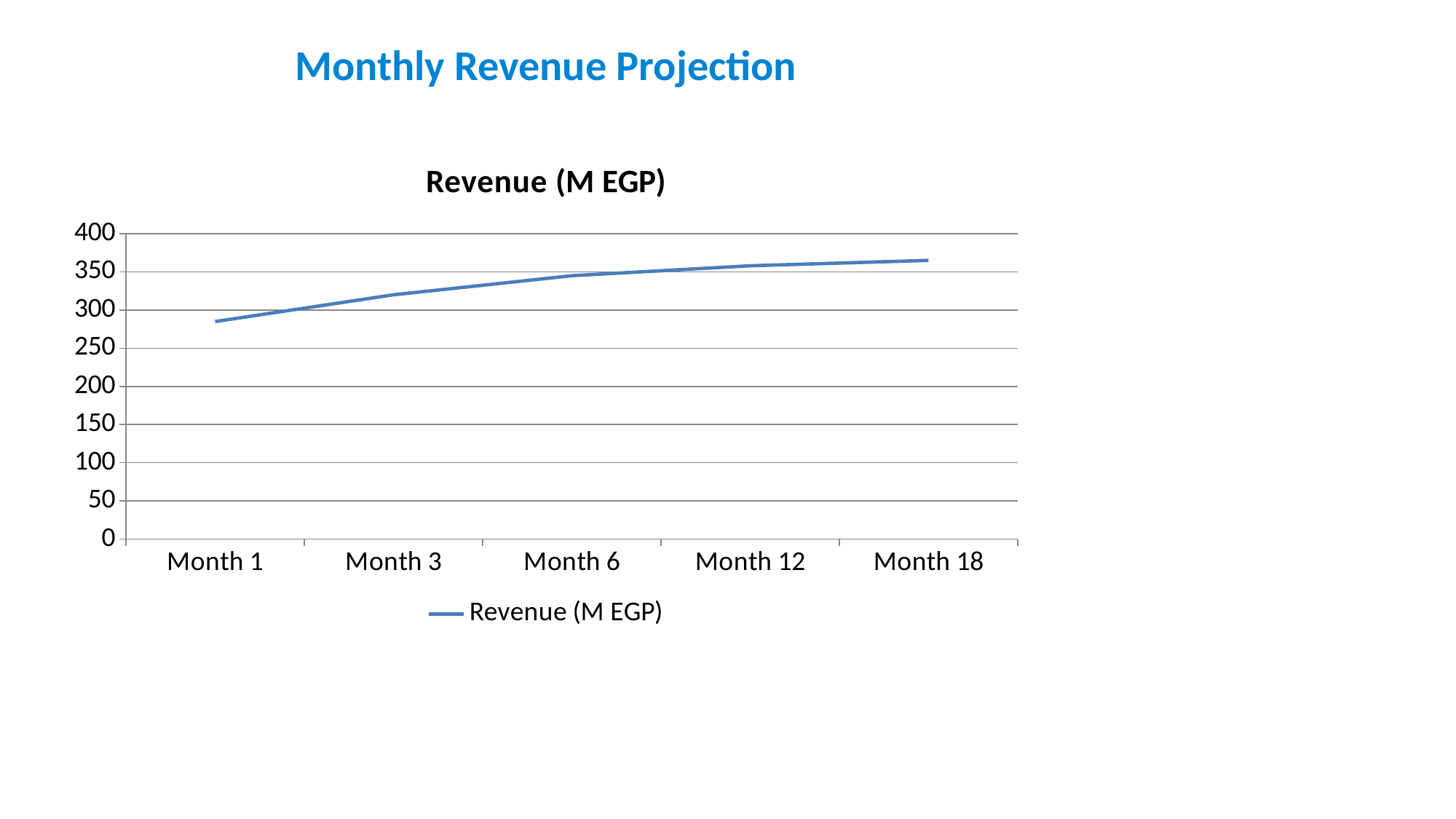
Which month has the highest revenue? Month 18 Which is larger, the revenue for Month 1 or the revenue for Month 6? Month 6 Is the revenue for Month 18 greater or less than 400? less What is the title of the chart? Revenue (M EGP) How many months are plotted on the x axis? 5 Do the revenue values rise or fall from Month 1 to Month 18? rise Which month has the lowest revenue? Month 1 How many series does the legend list? 1 Is the revenue for Month 18 greater or less than 350? greater Is the revenue for Month 3 greater or less than 300? greater What kind of chart is shown on the slide? line chart